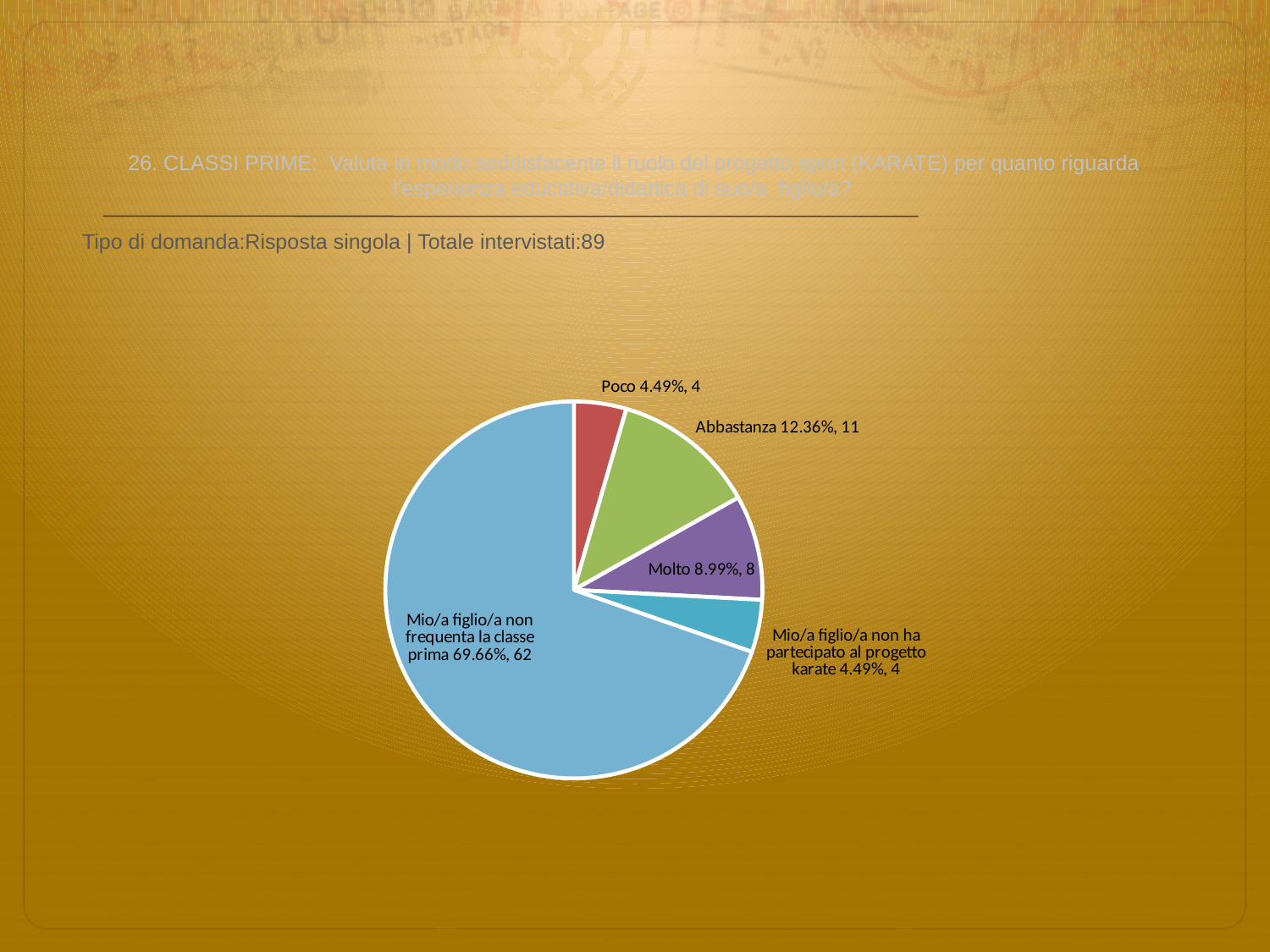
What percentage share does the 'Abbastanza' slice have? 12.36% How many respondents answered 'Abbastanza'? 11 What is the difference in count between 'Abbastanza' and 'Molto'? 3 How many respondents answered 'Poco'? 4 How many slices does the pie chart have? 5 What percentage share does the 'Mio/a figlio/a non frequenta la classe prima' slice have? 69.66% Which is larger, the 'Molto' slice or the 'Poco' slice? Molto How many respondents answered 'Mio/a figlio/a non ha partecipato al progetto karate'? 4 Which category has the largest slice of the pie? Mio/a figlio/a non frequenta la classe prima What percentage share does the 'Molto' slice have? 8.99% What colour is the 'Poco' slice? red What kind of chart is shown on the slide? pie chart